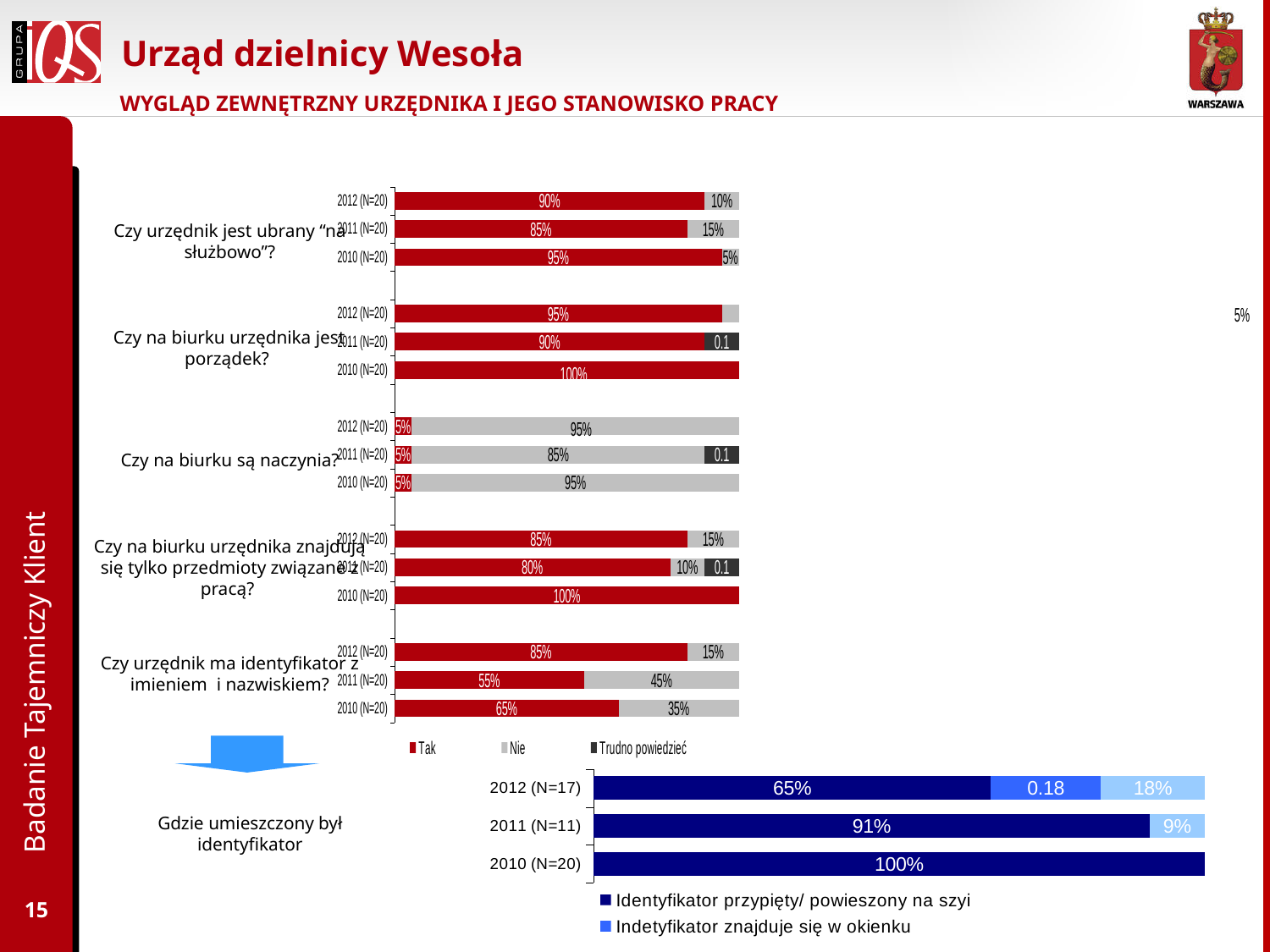
In the bottom chart 'Gdzie umieszczony był identyfikator', which year has the highest value for 'Identyfikator przypięty/ powieszony na szyi'? 2010 (N=20) In the bottom chart 'Gdzie umieszczony był identyfikator', how many years (bars) are shown? 3 In the top chart, for 'Czy urzędnik jest ubrany "na służbowo"?', which year has the highest 'Tak' value? 2010 (N=20) In the bottom chart 'Gdzie umieszczony był identyfikator', what is the value for 'Identyfikator przypięty/ powieszony na szyi' in 2011 (N=11)? 91% How many series does the legend of the top chart list? 3 In the top chart, what is the difference between the 'Tak' values for 'Czy urzędnik ma identyfikator z imieniem i nazwiskiem?' in 2012 and 2011? 30% In the top chart, what percentage answered 'Tak' to 'Czy urzędnik jest ubrany "na służbowo"?' in 2012 (N=20)? 90% What type of chart is the top chart? Stacked bar chart In the top chart, is the 'Tak' value for 'Czy na biurku urzędnika znajdują się tylko przedmioty związane z pracą?' larger in 2012 or in 2011? 2012 In the top chart, what is the 'Nie' value for 'Czy urzędnik ma identyfikator z imieniem i nazwiskiem?' in 2011 (N=20)? 45% In the top chart, what is the 'Tak' value for 'Czy na biurku urzędnika jest porządek?' in 2010 (N=20)? 100% In the top chart, for 'Czy urzędnik ma identyfikator z imieniem i nazwiskiem?', which year has the lowest 'Tak' value? 2011 (N=20)